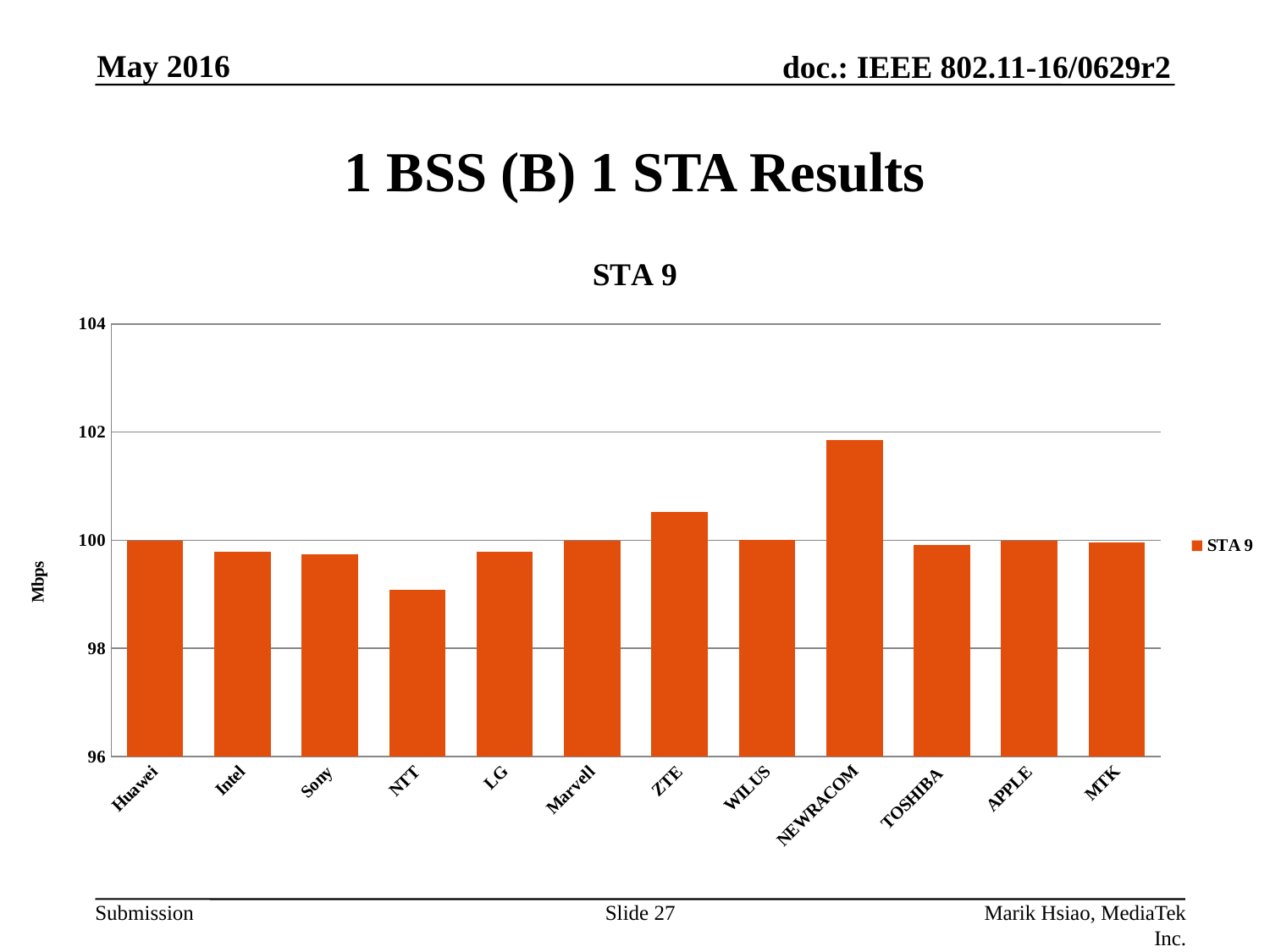
Is the value for ZTE greater or less than 100? greater How many companies are shown on the x axis of the chart? 12 Which company has the lowest value in the chart? NTT Which has the larger value, NEWRACOM or ZTE? NEWRACOM Is the value for NTT greater or less than 100? less What is the title of the chart? STA 9 What type of chart is shown on the slide? bar chart Which company has the highest value in the chart? NEWRACOM How many series does the legend list? 1 Which has the larger value, Intel or NTT? Intel Is the value for NEWRACOM greater or less than 102? less What is the label on the vertical axis of the chart? Mbps